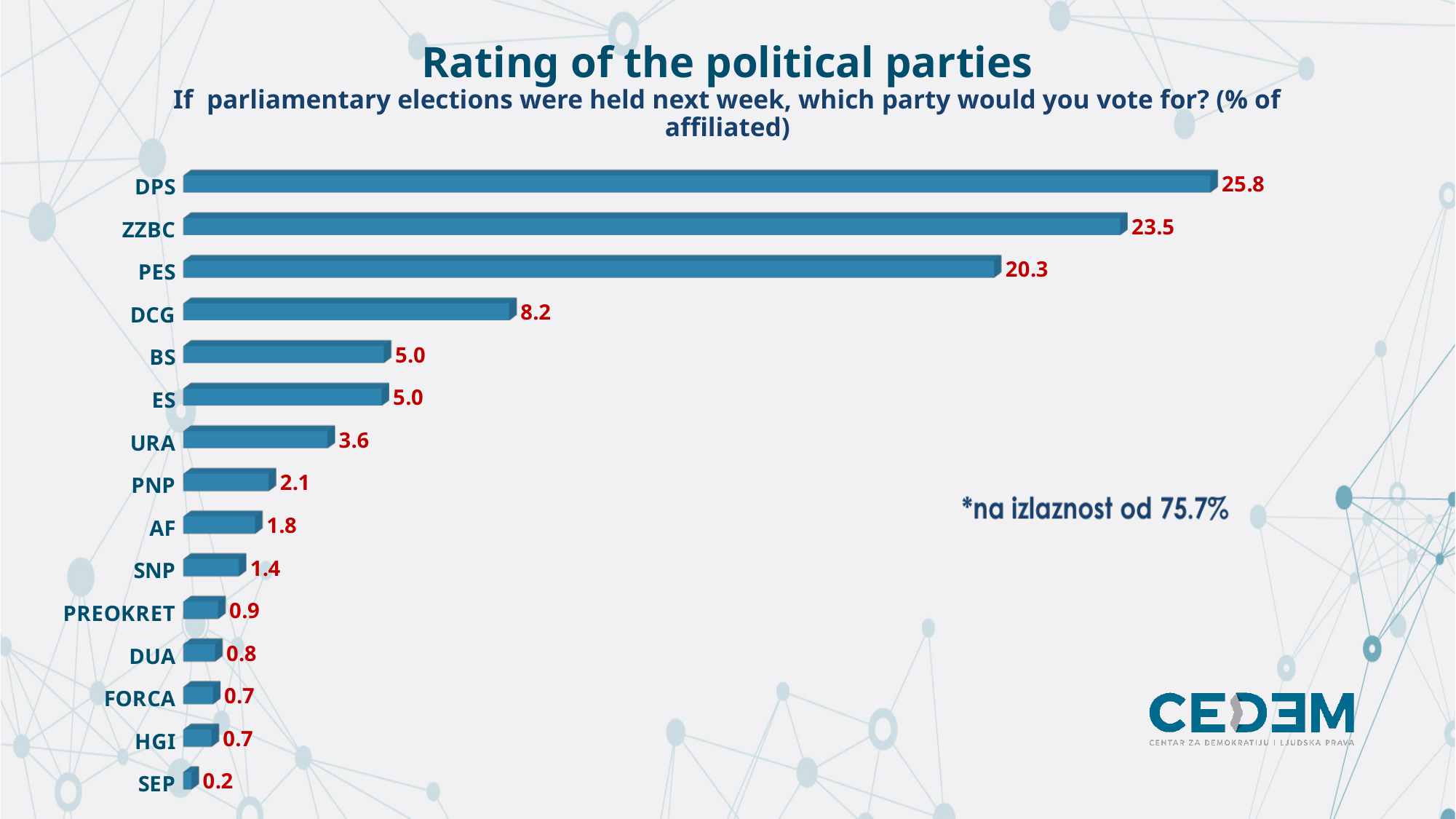
Which party has the highest value? DPS What is the value for URA? 3.6 Which party has the lowest value? SEP What is the value for DCG? 8.2 What is the difference between the values for DPS and ZZBC? 2.3 How many parties are shown in the chart? 15 What kind of chart is shown on the slide? Bar chart What is the value for SNP? 1.4 What is the value for DPS? 25.8 What is the title of the chart? Rating of the political parties What is the difference between the values for PES and DCG? 12.1 Which is larger, the value for PNP or the value for AF? PNP